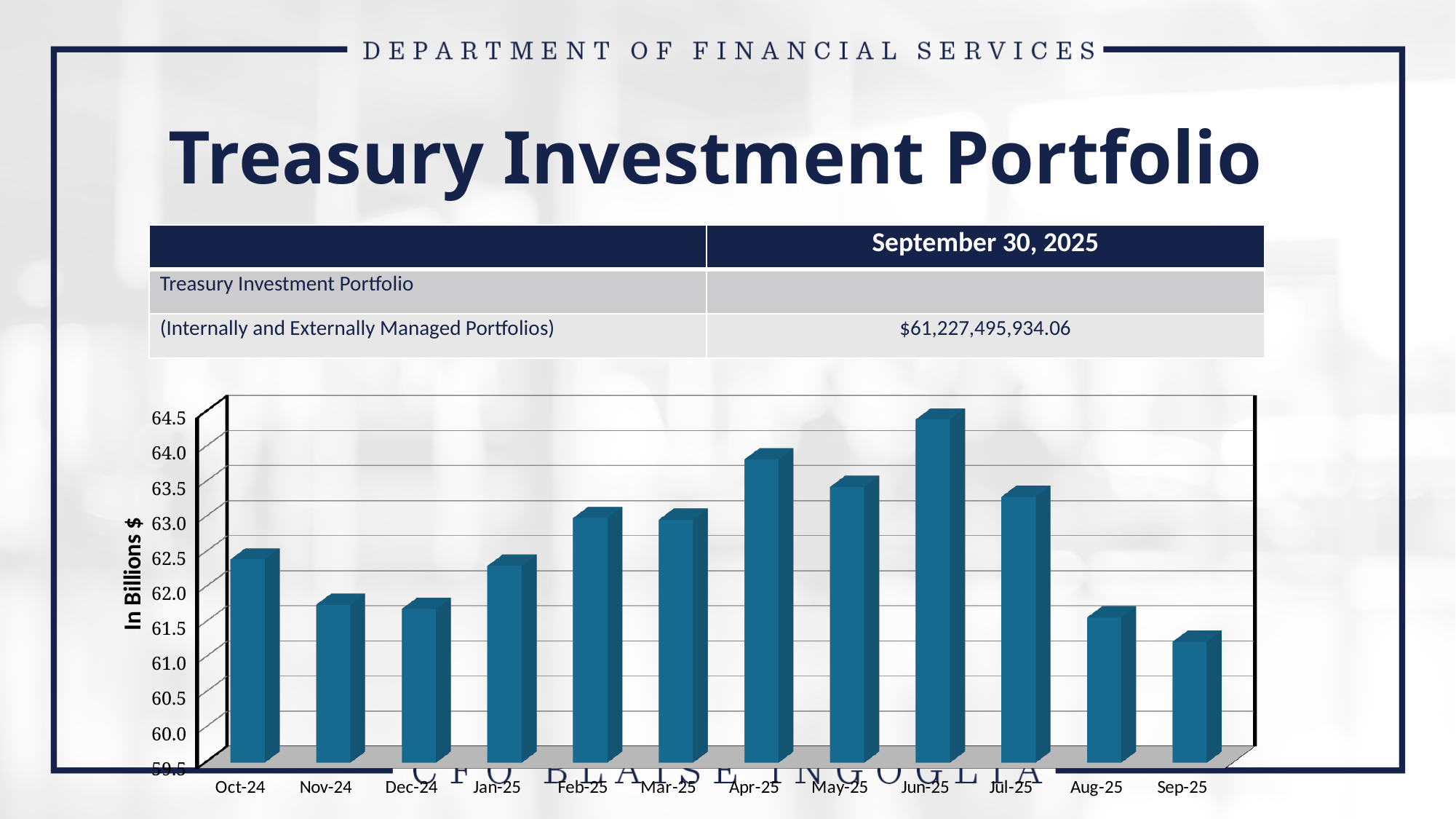
Do the values rise or fall from Jun-25 to Sep-25? fall Is the value for Sep-25 greater or less than 61.5? less Is the value for Apr-25 greater or less than 63.5? greater What kind of chart is shown on the slide? bar chart Is the value for Nov-24 greater or less than 62.0? less How many months are plotted on the chart? 12 Which is larger, the value for Jul-25 or the value for Aug-25? Jul-25 Which month has the highest value on the chart? Jun-25 What is the label on the vertical axis of the chart? In Billions $ Which is larger, the value for Apr-25 or the value for May-25? Apr-25 Which month has the lowest value on the chart? Sep-25